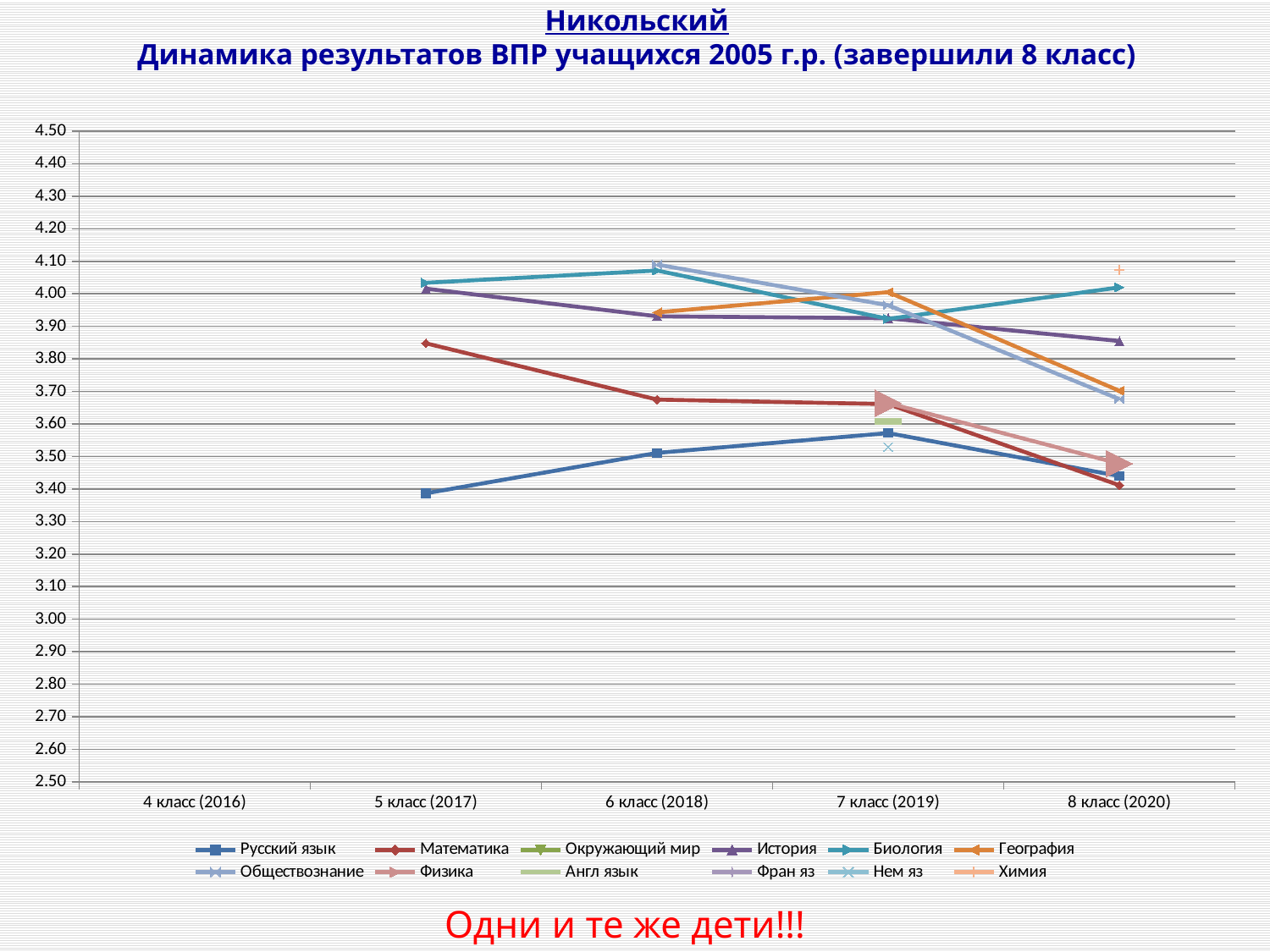
At 5 класс (2017), which series has the lowest value? Русский язык Is the value for Обществознание at 6 класс (2018) greater or less than 4.00? greater Is the value for Биология at 8 класс (2020) greater or less than 3.90? greater What kind of chart is shown on the slide? line chart Is the value for Математика at 5 класс (2017) greater or less than 3.80? greater What is the title of the chart? Никольский Динамика результатов ВПР учащихся 2005 г.р. (завершили 8 класс) At 8 класс (2020), which is larger: the value for Биология or the value for Математика? Биология Does the Математика line rise or fall from 5 класс (2017) to 8 класс (2020)? fall How many categories are shown along the x axis? 5 How many series does the legend list? 12 Does the История line rise or fall from 5 класс (2017) to 8 класс (2020)? fall